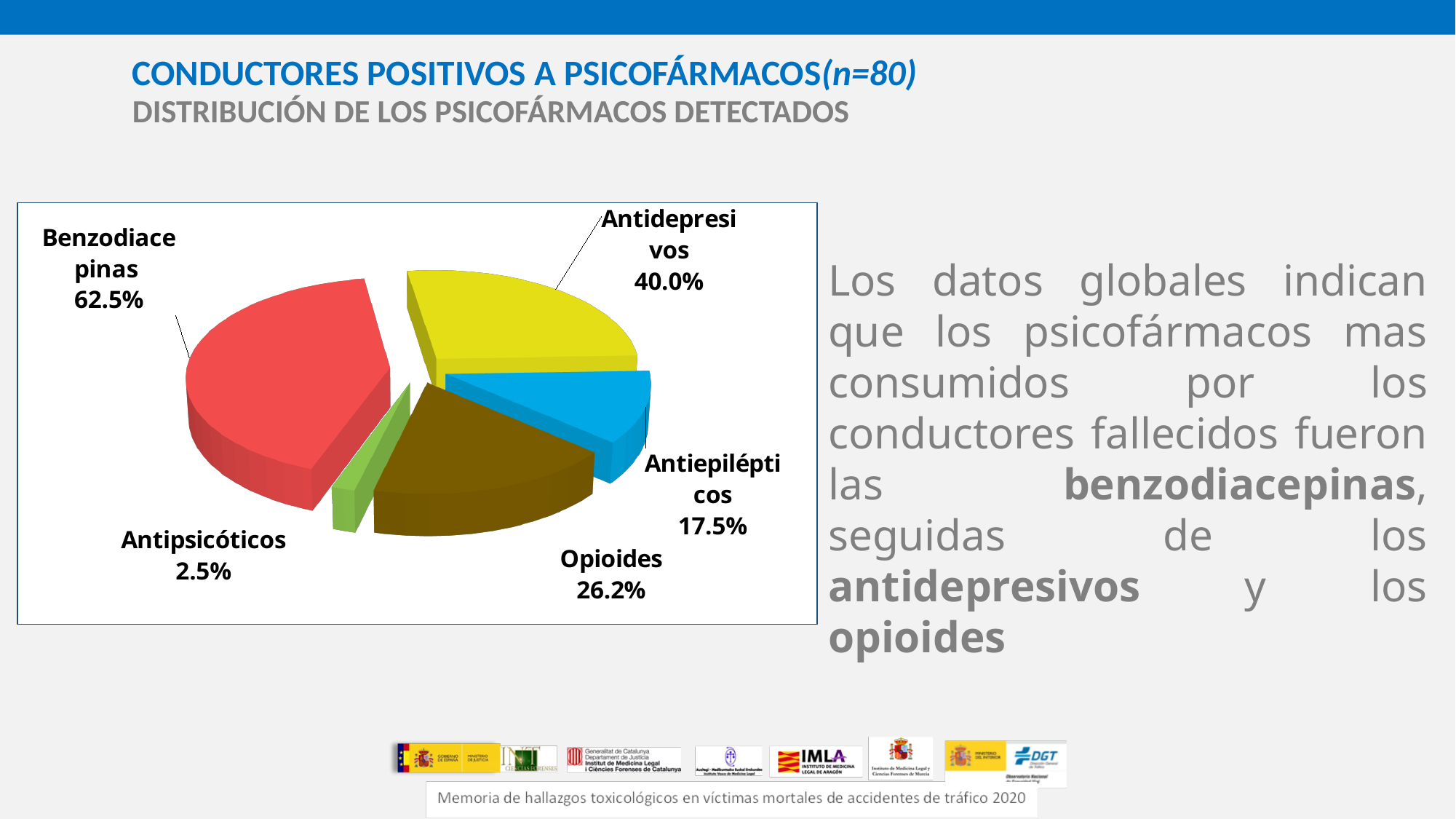
Which category has the highest percentage? Benzodiacepinas How many categories are shown in the pie chart? 5 What percentage is shown for Antidepresivos? 40.0% What colour is the Benzodiacepinas slice? Red What percentage is shown for Antipsicóticos? 2.5% What percentage is shown for Opioides? 26.2% Which is larger, the percentage for Opioides or for Antiepilépticos? Opioides What is the difference in percentage points between Benzodiacepinas and Antidepresivos? 22.5 What percentage is shown for Benzodiacepinas? 62.5% Which category has the lowest percentage? Antipsicóticos What percentage is shown for Antiepilépticos? 17.5% What kind of chart is shown on the slide? Pie chart